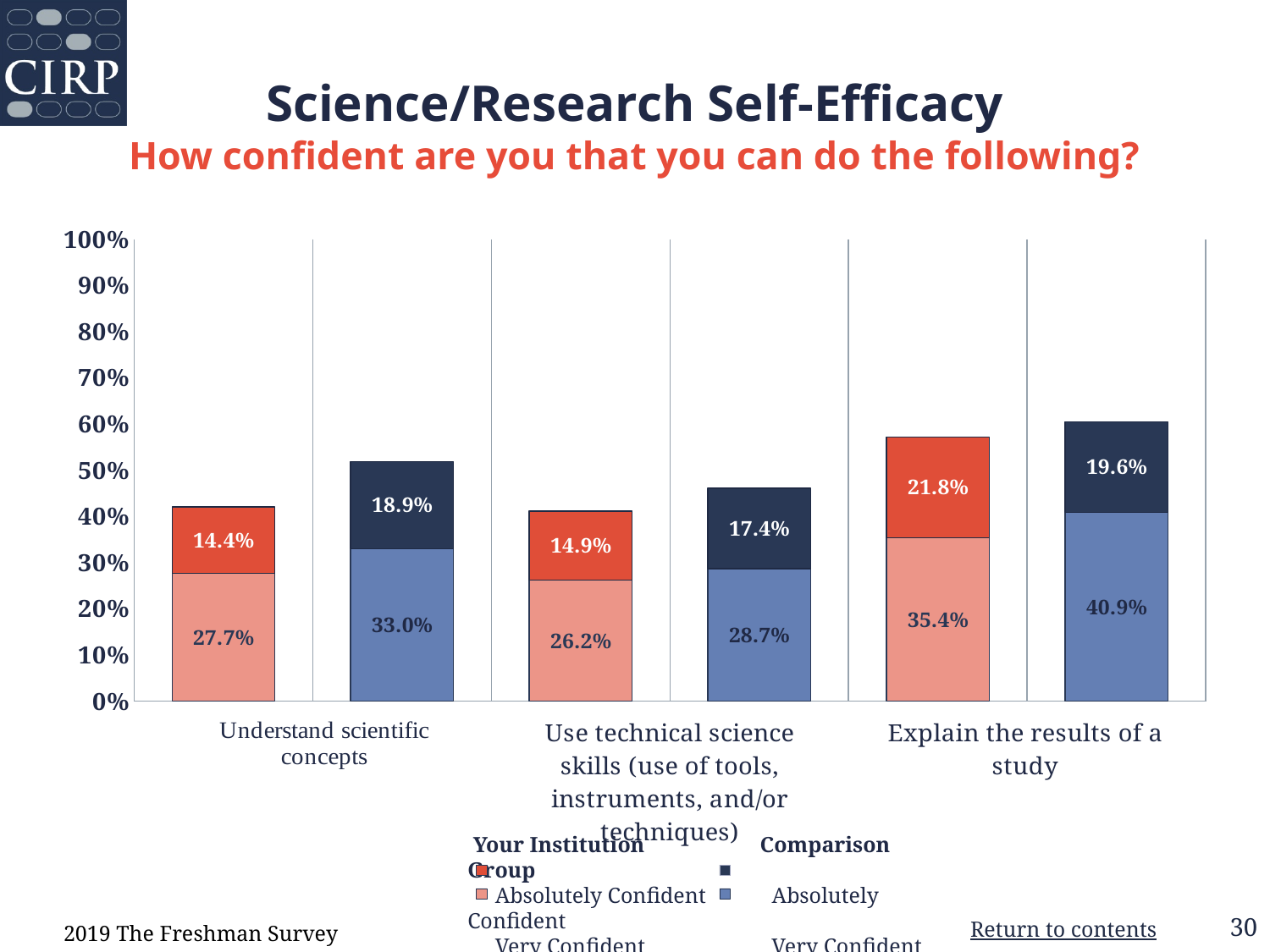
What is the subtitle question shown in orange below the chart title? How confident are you that you can do the following? Is the total of the Your Institution bar for 'Use technical science skills' greater or less than 50%? less What is the value of the bottom segment of the Comparison Group bar for 'Explain the results of a study'? 40.9% What is the total of the Your Institution stacked bar for 'Explain the results of a study'? 57.2% What is the value of the top segment of the Comparison Group bar for 'Use technical science skills (use of tools, instruments, and/or techniques)'? 17.4% How many categories (survey items) are shown along the x axis? 3 What is the difference between the bottom segments of the Comparison Group and Your Institution bars for 'Understand scientific concepts'? 5.3% What type of chart is shown on the slide? stacked bar chart Which category has the tallest Comparison Group stacked bar? Explain the results of a study What is the value of the bottom segment of the Your Institution bar for 'Understand scientific concepts'? 27.7% What is the total of the Comparison Group stacked bar for 'Understand scientific concepts'? 51.9% Which is larger: the top segment of the Your Institution bar or the top segment of the Comparison Group bar for 'Explain the results of a study'? Your Institution (21.8%)